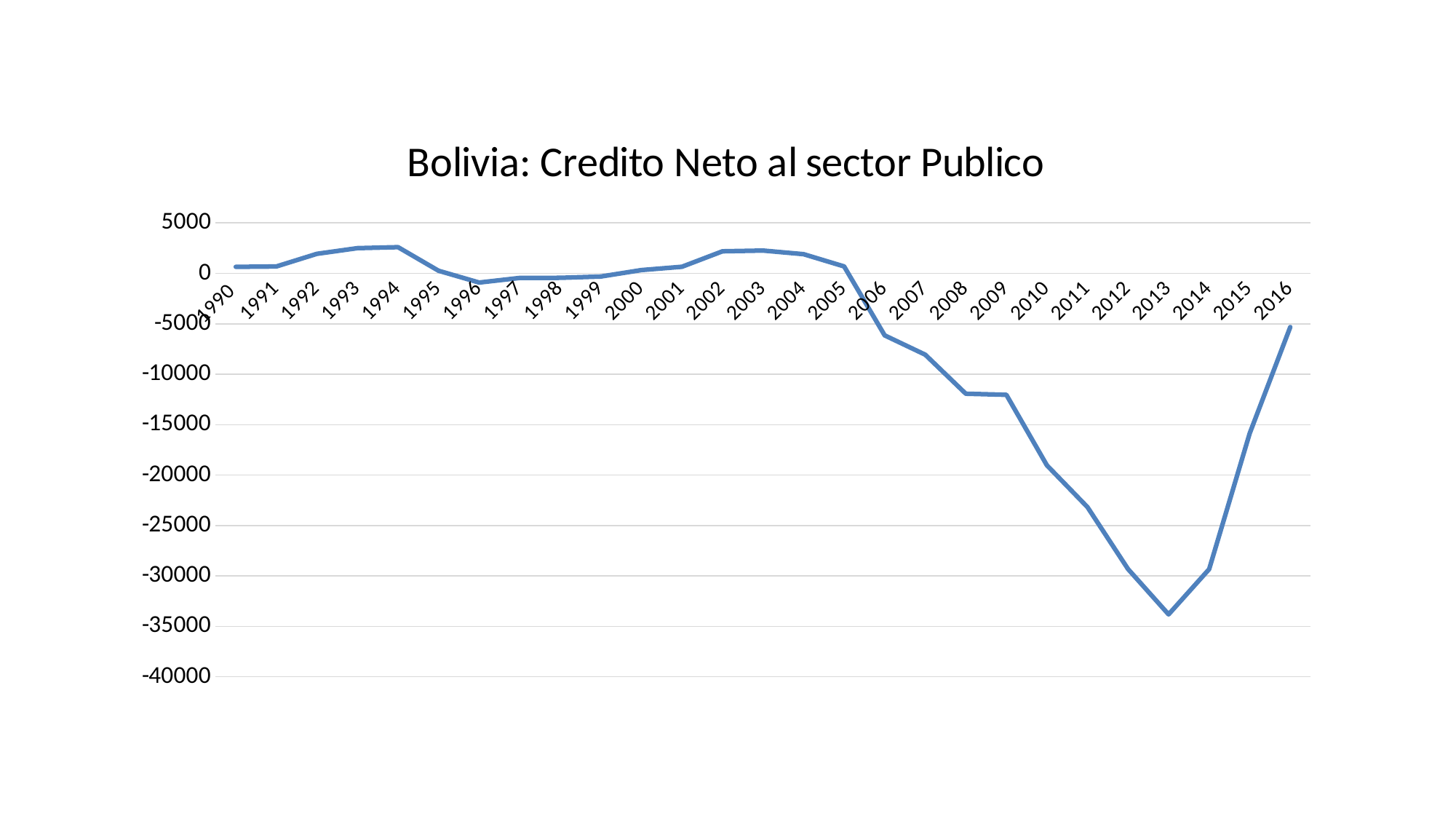
Is the value for 2016 greater or less than -10000? greater Which is larger, the value for 2013 or the value for 2014? 2014 What kind of chart is shown on the slide? line chart Is the value for 2015 greater or less than -20000? greater Is the value for 2013 greater or less than -30000? less What is the title of the chart? Bolivia: Credito Neto al sector Publico Which year has the lowest value? 2013 How many years are plotted along the x axis? 27 Which is larger, the value for 2006 or the value for 2010? 2006 Do the values rise or fall from 2005 to 2013? fall